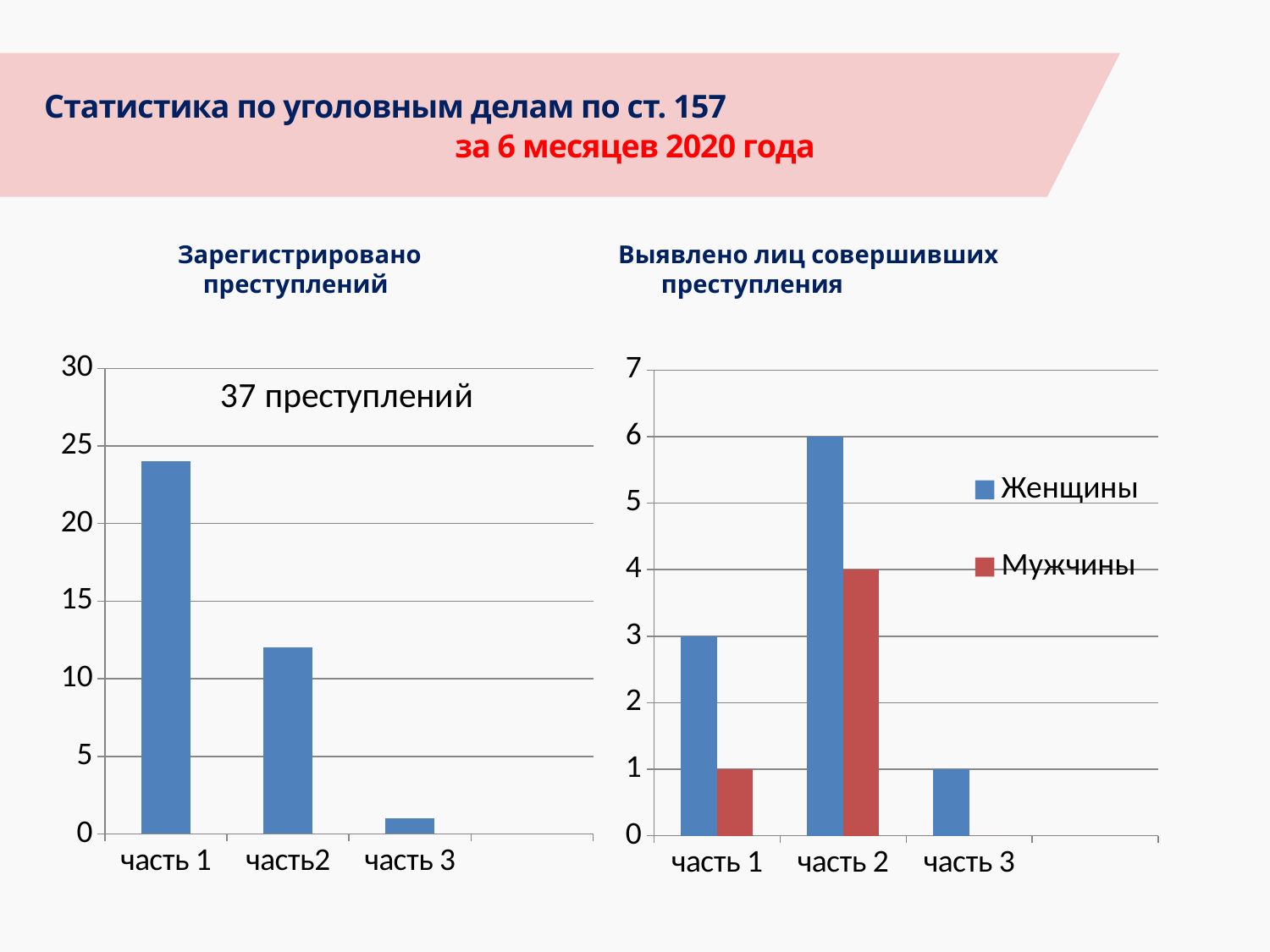
In the chart titled "Выявлено лиц совершивших преступления", what is the value for Мужчины in часть 2? 4 In the chart titled "Выявлено лиц совершивших преступления", what is the value for Женщины in часть 1? 3 In the chart titled "Выявлено лиц совершивших преступления", what is the value for Женщины in часть 2? 6 In the chart titled "Зарегистрировано преступлений", which category has the highest value? часть 1 In the chart titled "Выявлено лиц совершивших преступления", how many series does the legend list? 2 In the chart titled "Зарегистрировано преступлений", how many categories are shown on the x axis? 3 What kind of chart is the chart titled "Зарегистрировано преступлений"? bar chart In the chart titled "Выявлено лиц совершивших преступления", what is the value for Мужчины in часть 1? 1 In the chart titled "Выявлено лиц совершивших преступления", which category has the highest value for Женщины? часть 2 In the chart titled "Выявлено лиц совершивших преступления", what is the difference between Женщины and Мужчины in часть 2? 2 In the chart titled "Зарегистрировано преступлений", is the value for часть 1 greater or less than 20? greater In the chart titled "Зарегистрировано преступлений", is the value for часть2 greater or less than 15? less